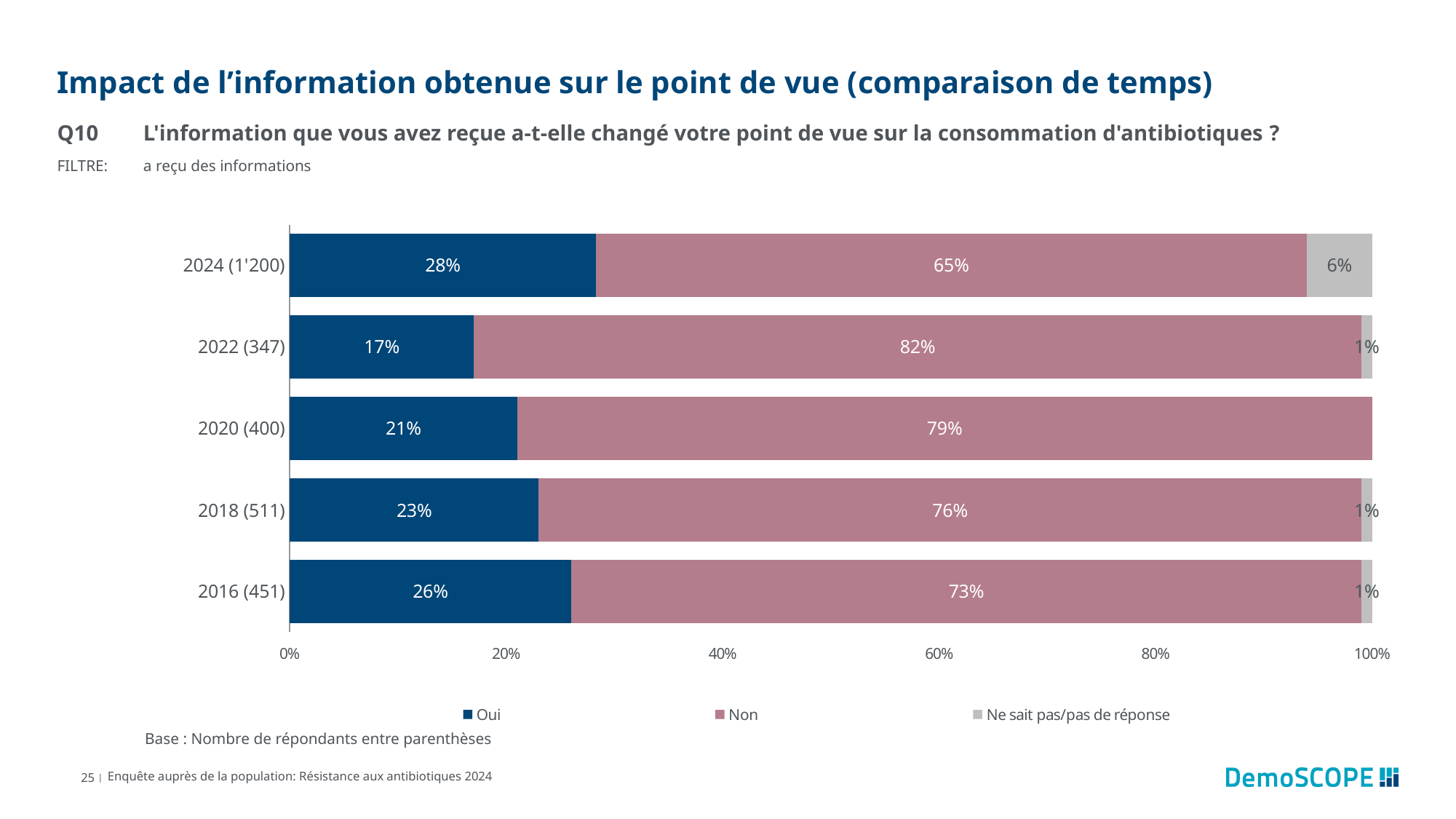
Which is larger, the "Oui" value for 2016 (451) or for 2018 (511)? 2016 (451) What is the value for "Oui" in 2024 (1'200)? 28% What kind of chart is shown on the slide? Stacked bar chart Which year has the highest "Oui" value? 2024 (1'200) What is the value for "Non" in 2022 (347)? 82% Which year has the highest "Non" value? 2022 (347) What is the base (number of respondents) for 2020? 400 How many series does the legend list? 3 Which year has the lowest "Oui" value? 2022 (347) What is the difference between the "Non" values for 2022 (347) and 2024 (1'200)? 17 percentage points What is the value for "Ne sait pas/pas de réponse" in 2024 (1'200)? 6% How many years (categories) are shown on the chart? 5